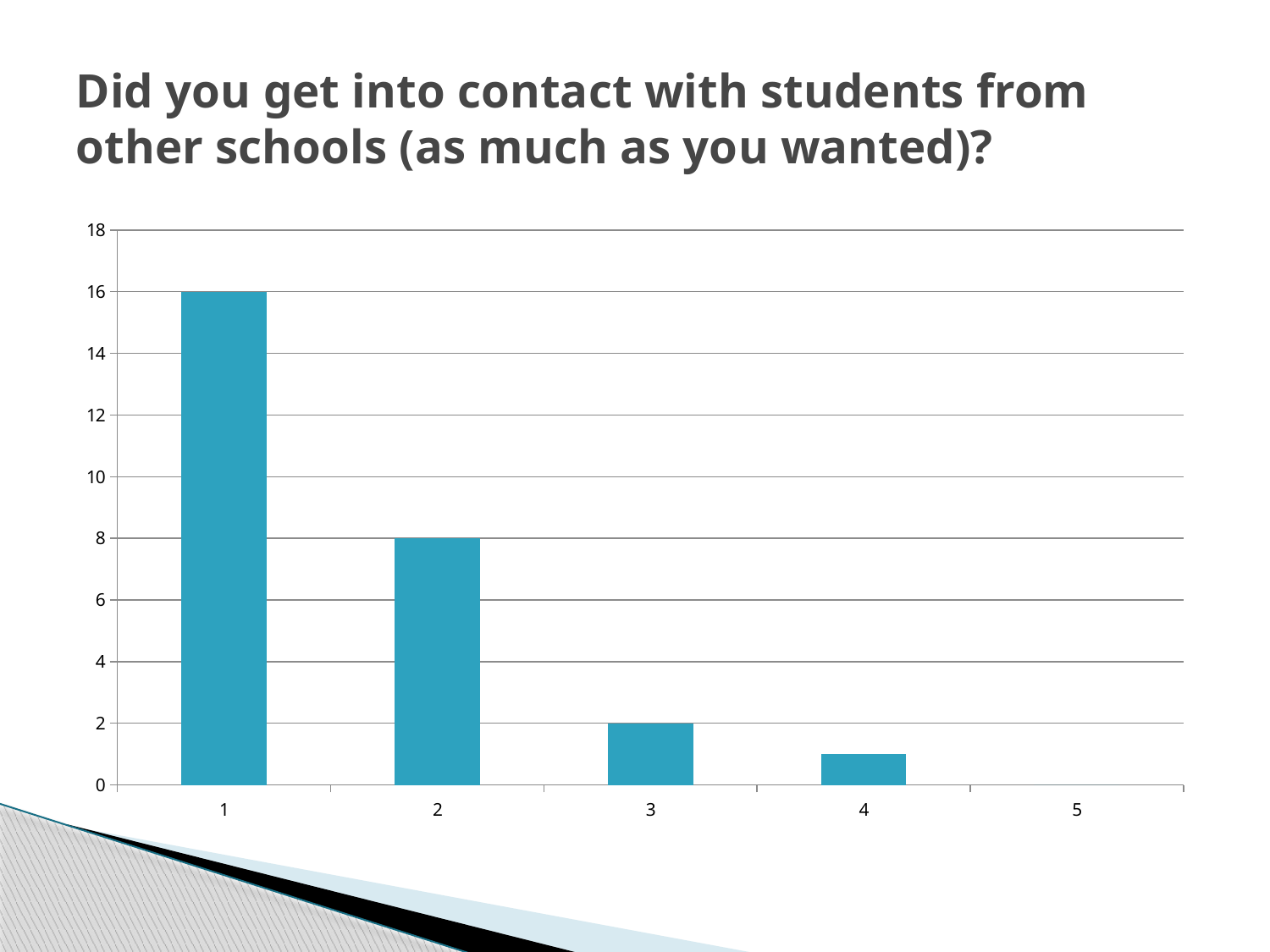
Which has the larger value, category 2 or category 3? 2 What is the difference between the values for category 1 and category 2? 8 What is the value for category 1? 16 Which category has the highest value? 1 Do the values rise or fall from category 1 to category 5? fall Is the value for category 4 greater or less than 2? less What is the value for category 3? 2 What is the value for category 2? 8 What kind of chart is shown on the slide? bar chart What is the difference between the values for category 2 and category 3? 6 Which category has the lowest value? 5 How many categories are shown on the x axis? 5